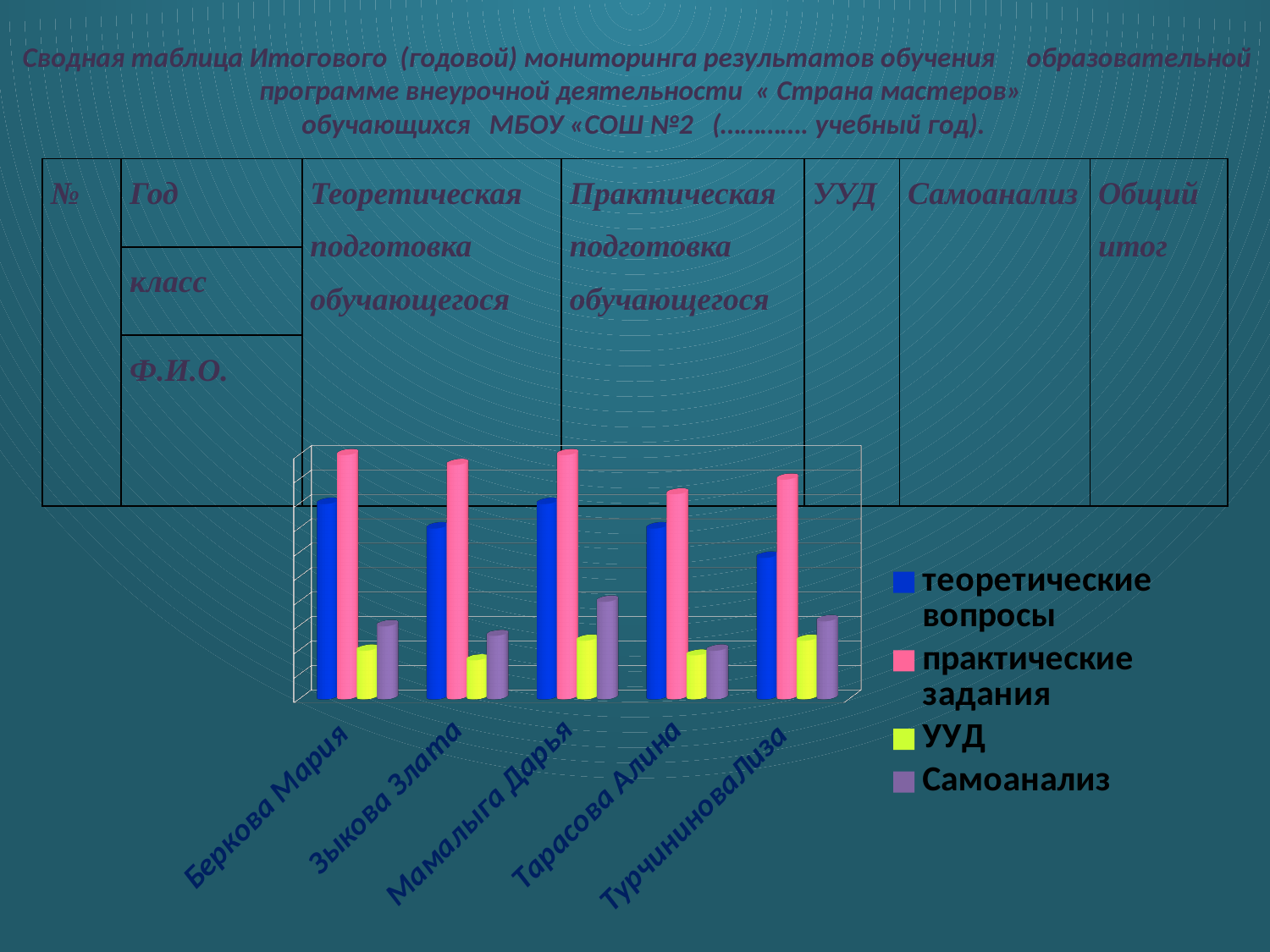
For Тарасова Алина, which is larger: теоретические вопросы or УУД? теоретические вопросы How many students (categories) are shown on the x axis of the chart? 5 Which series is shown in blue in the chart legend? теоретические вопросы What kind of chart is shown on the slide? bar chart For Мамалыга Дарья, which is larger: Самоанализ or УУД? Самоанализ How many series does the chart legend list? 4 Which series is shown in pink in the chart legend? практические задания For Беркова Мария, which is larger: практические задания or теоретические вопросы? практические задания Which student has the lowest bar for теоретические вопросы? ТурчининоваЛиза Which student has the highest bar for Самоанализ? Мамалыга Дарья Which series has the tallest bar for every student in the chart? практические задания